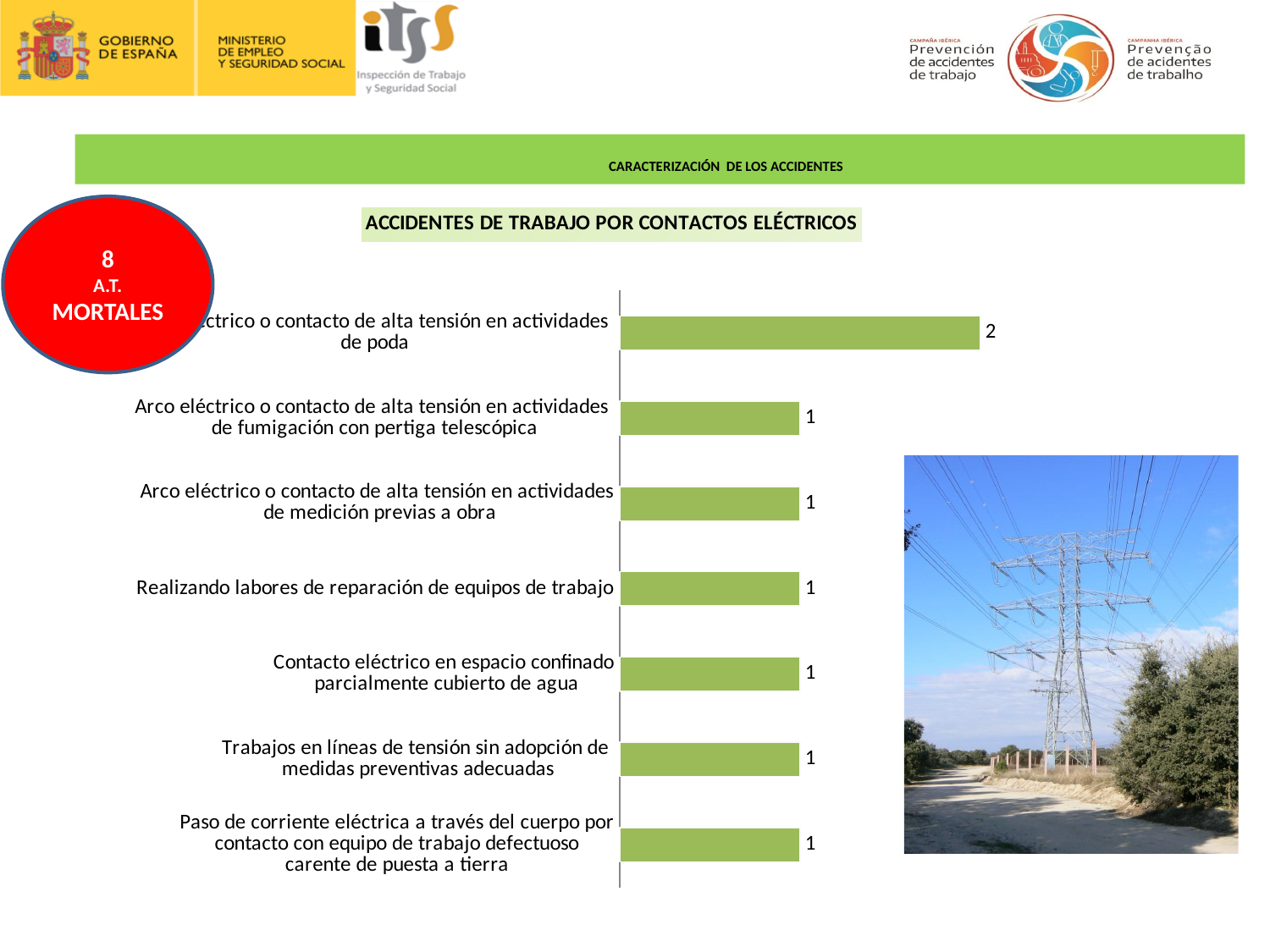
What is the title of the chart? ACCIDENTES DE TRABAJO POR CONTACTOS ELÉCTRICOS What is the value for 'Realizando labores de reparación de equipos de trabajo'? 1 How many categories (bars) does the chart show? 7 What is the difference between the top bar (actividades de poda) and 'Trabajos en líneas de tensión sin adopción de medidas preventivas adecuadas'? 1 How many categories have a value of 1? 6 What is the value for 'Arco eléctrico o contacto de alta tensión en actividades de fumigación con pertiga telescópica'? 1 What is the value for 'Contacto eléctrico en espacio confinado parcialmente cubierto de agua'? 1 What is the total of all the bar values in the chart? 8 Which is larger: the top bar (actividades de poda) or 'Paso de corriente eléctrica a través del cuerpo por contacto con equipo de trabajo defectuoso carente de puesta a tierra'? The top bar (actividades de poda) What kind of chart is shown on the slide? Bar chart Which category has the highest value? The top bar, contacto de alta tensión en actividades de poda What is the value of the top bar, the category ending in 'actividades de poda'? 2